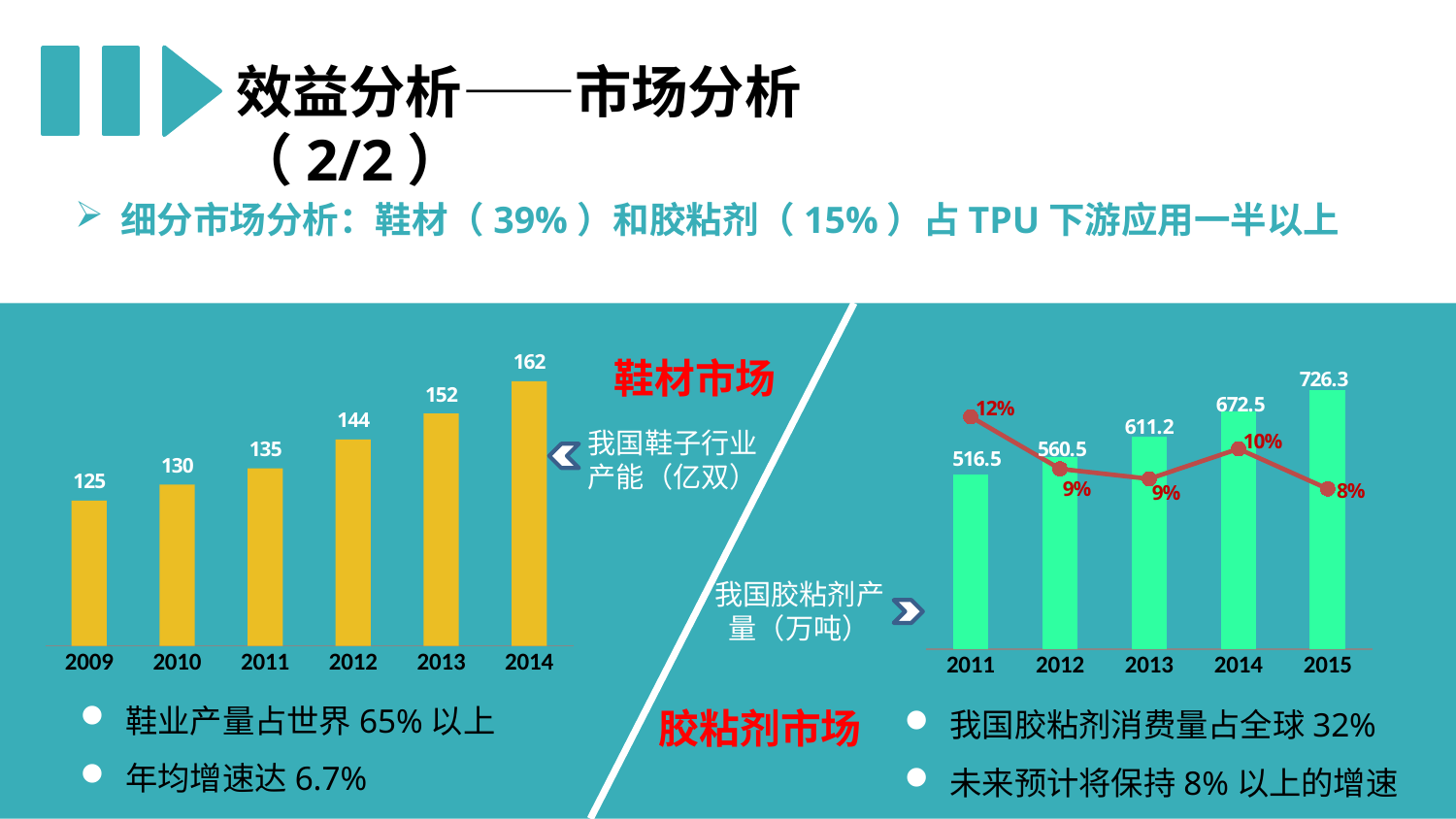
In the right chart (我国胶粘剂产量), which is larger, the growth rate for 2014 or for 2015? 2014 In the left chart (我国鞋子行业产能), what is the difference between the 2014 and 2009 values? 37 In the right chart (我国胶粘剂产量), which year has the highest bar value? 2015 In the left chart (我国鞋子行业产能), do the values rise or fall from 2009 to 2014? rise In the left chart (我国鞋子行业产能), what is the value for 2012? 144 What kind of chart is the left chart (我国鞋子行业产能)? bar chart In the left chart (我国鞋子行业产能), which year has the lowest value? 2009 In the right chart (我国胶粘剂产量), what is the difference between the 2015 and 2014 bar values? 53.8 In the left chart (我国鞋子行业产能), which year has the highest value? 2014 In the right chart (我国胶粘剂产量), what growth rate is shown on the line for 2011? 12% In the left chart (我国鞋子行业产能), how many years are plotted? 6 In the right chart (我国胶粘剂产量), what is the bar value for 2013? 611.2